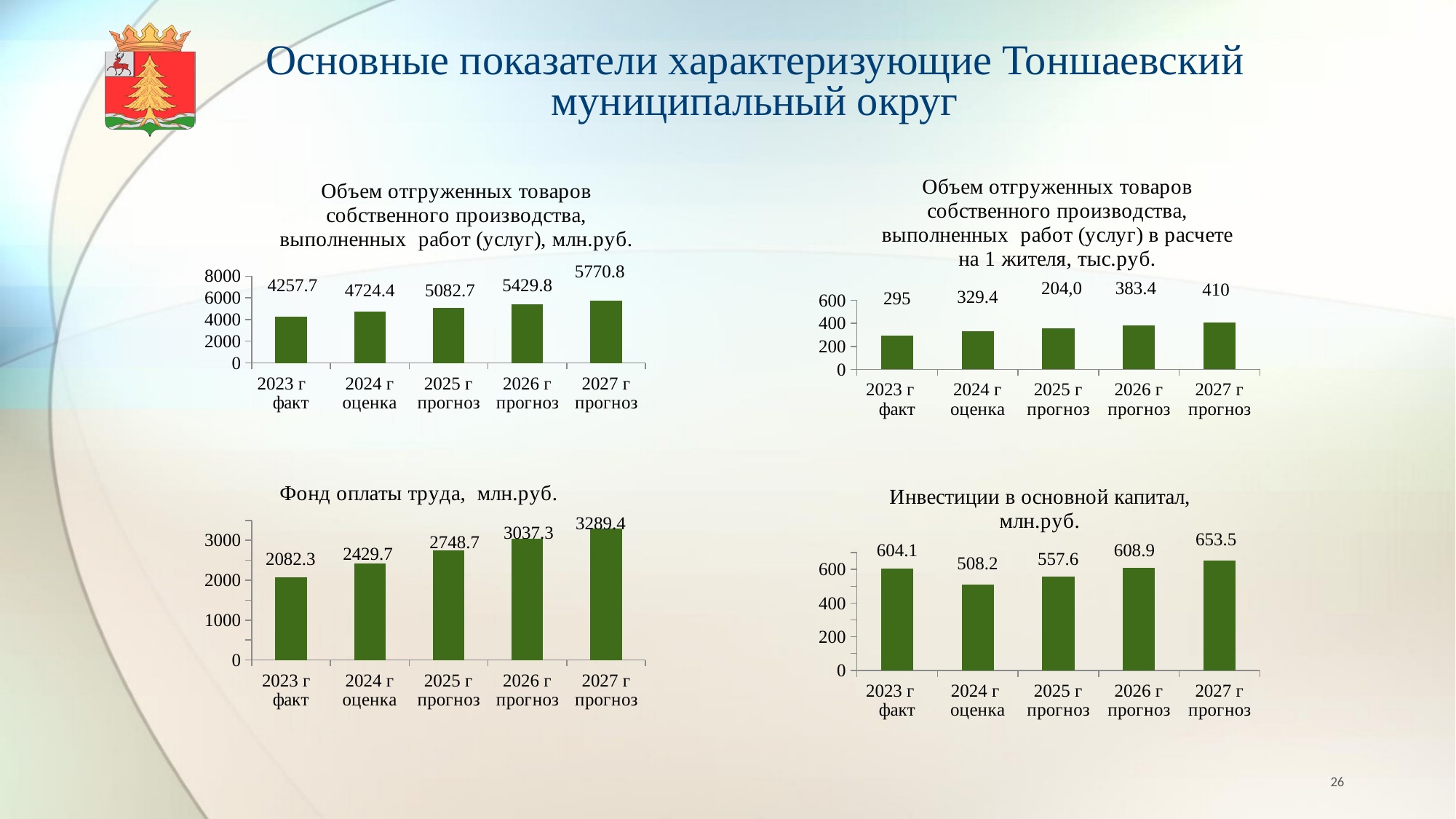
In the bottom-right chart (Инвестиции в основной капитал, млн.руб.), which is larger: the value for 2023 г факт or 2025 г прогноз? 2023 г факт In the top-left chart (Объем отгруженных товаров ... млн.руб.), which year has the highest value? 2027 г прогноз In the bottom-right chart (Инвестиции в основной капитал, млн.руб.), how many years are shown on the x axis? 5 In the bottom-left chart (Фонд оплаты труда, млн.руб.), what is the value for 2024 г оценка? 2429.7 In the bottom-left chart (Фонд оплаты труда, млн.руб.), which year has the lowest value? 2023 г факт In the top-left chart (Объем отгруженных товаров ... млн.руб.), what is the value for 2025 г прогноз? 5082.7 In the bottom-right chart (Инвестиции в основной капитал, млн.руб.), what is the value for 2024 г оценка? 508.2 What type of chart is the bottom-right chart (Инвестиции в основной капитал, млн.руб.)? bar chart In the top-right chart (per capita, тыс.руб.), what is the value for 2027 г прогноз? 410 In the top-right chart (per capita, тыс.руб.), is the value for 2023 г факт greater or less than 400? less In the bottom-left chart (Фонд оплаты труда, млн.руб.), do the values rise or fall from 2023 to 2027? rise In the top-left chart (Объем отгруженных товаров ... млн.руб.), what is the difference between the 2027 г прогноз and 2023 г факт values? 1513.1